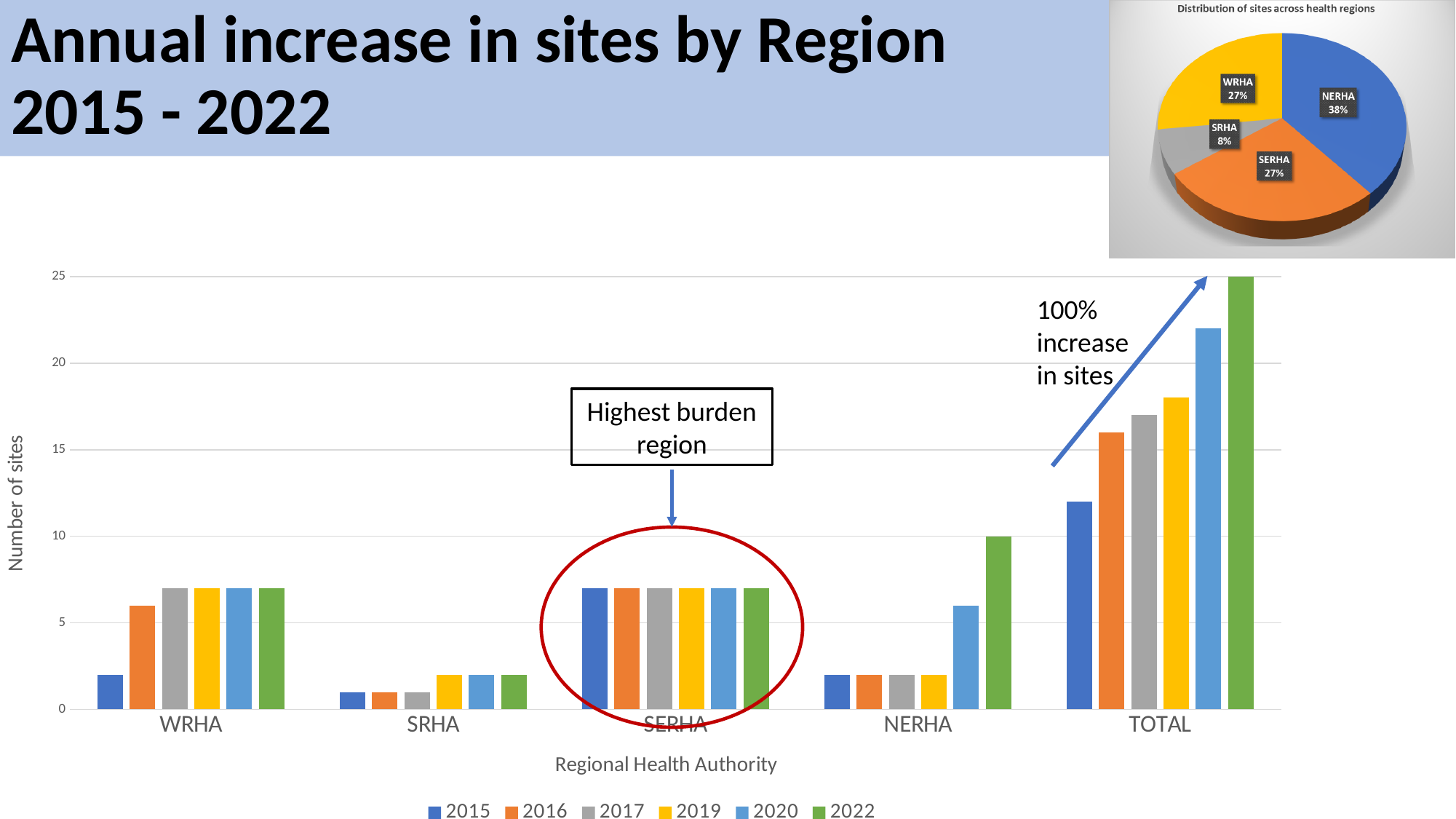
On the bar chart, how many regional health authority categories are shown on the x axis? 5 On the bar chart, how many series does the legend list? 6 On the bar chart, is the value for TOTAL in 2015 greater or less than 10? greater On the pie chart, which region has the smallest slice? SRHA On the bar chart, what is the value for NERHA in 2022? 10 On the bar chart, what kind of chart is it? bar chart On the pie chart, what is the difference between the NERHA share and the SRHA share? 30% On the bar chart, is the value for SRHA in 2022 greater or less than 5? less On the pie chart, what share does NERHA have? 38% On the bar chart, do the TOTAL values rise or fall from 2015 to 2022? rise On the bar chart, which category has the lowest bars overall? SRHA